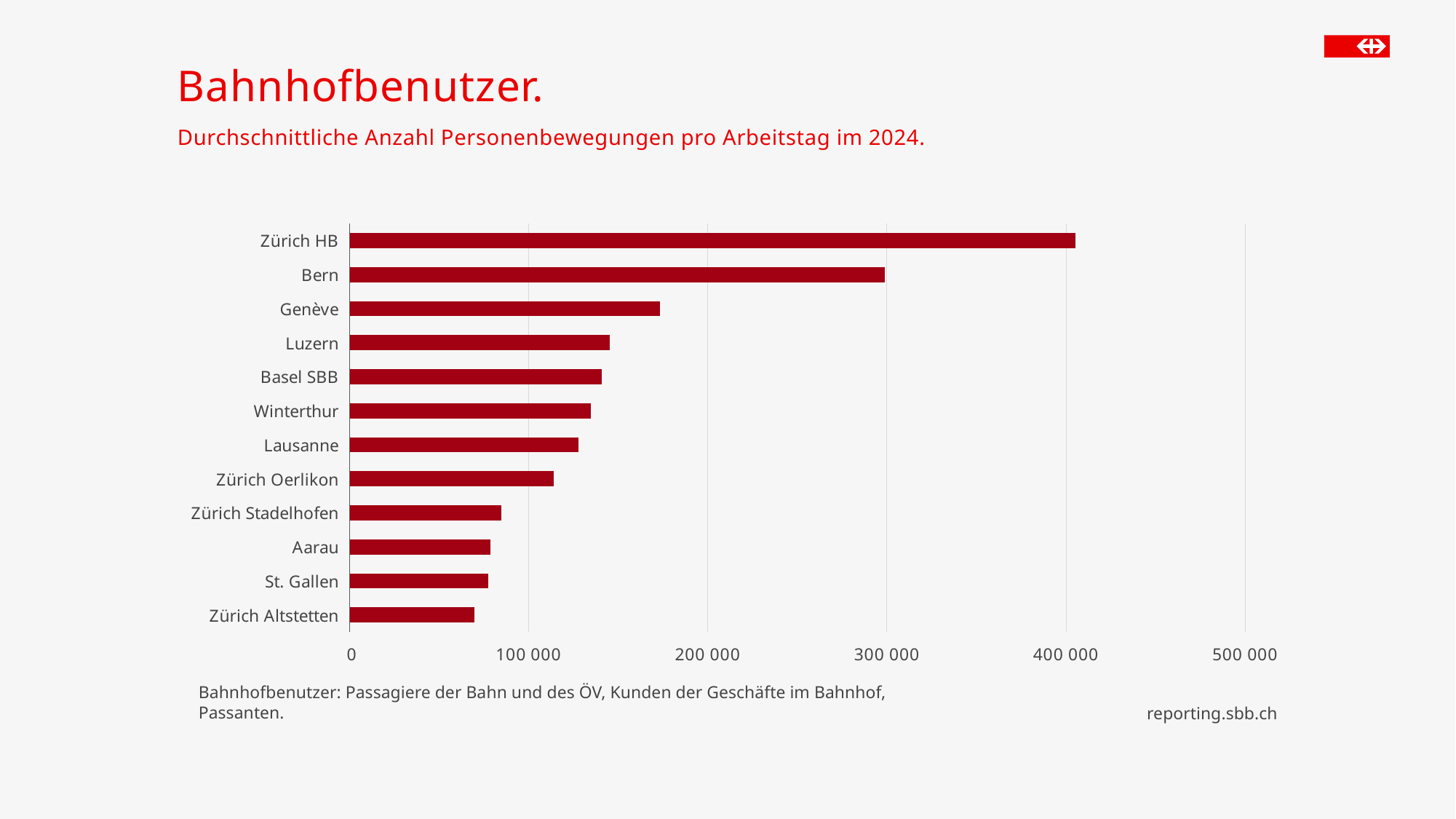
Which station has the lowest number of Personenbewegungen? Zürich Altstetten Is the value for Zürich Stadelhofen greater or less than 100 000? less What is the highest value shown on the horizontal axis? 500 000 What is the title of the slide? Bahnhofbenutzer. What kind of chart is shown on the slide? bar chart How many stations are listed in the chart? 12 Which station has the highest number of Personenbewegungen? Zürich HB Is the value for Zürich HB greater or less than 400 000? greater Which has a higher value, Bern or Genève? Bern Is the value for Zürich Oerlikon greater or less than 100 000? greater Which has a higher value, Lausanne or Zürich Oerlikon? Lausanne